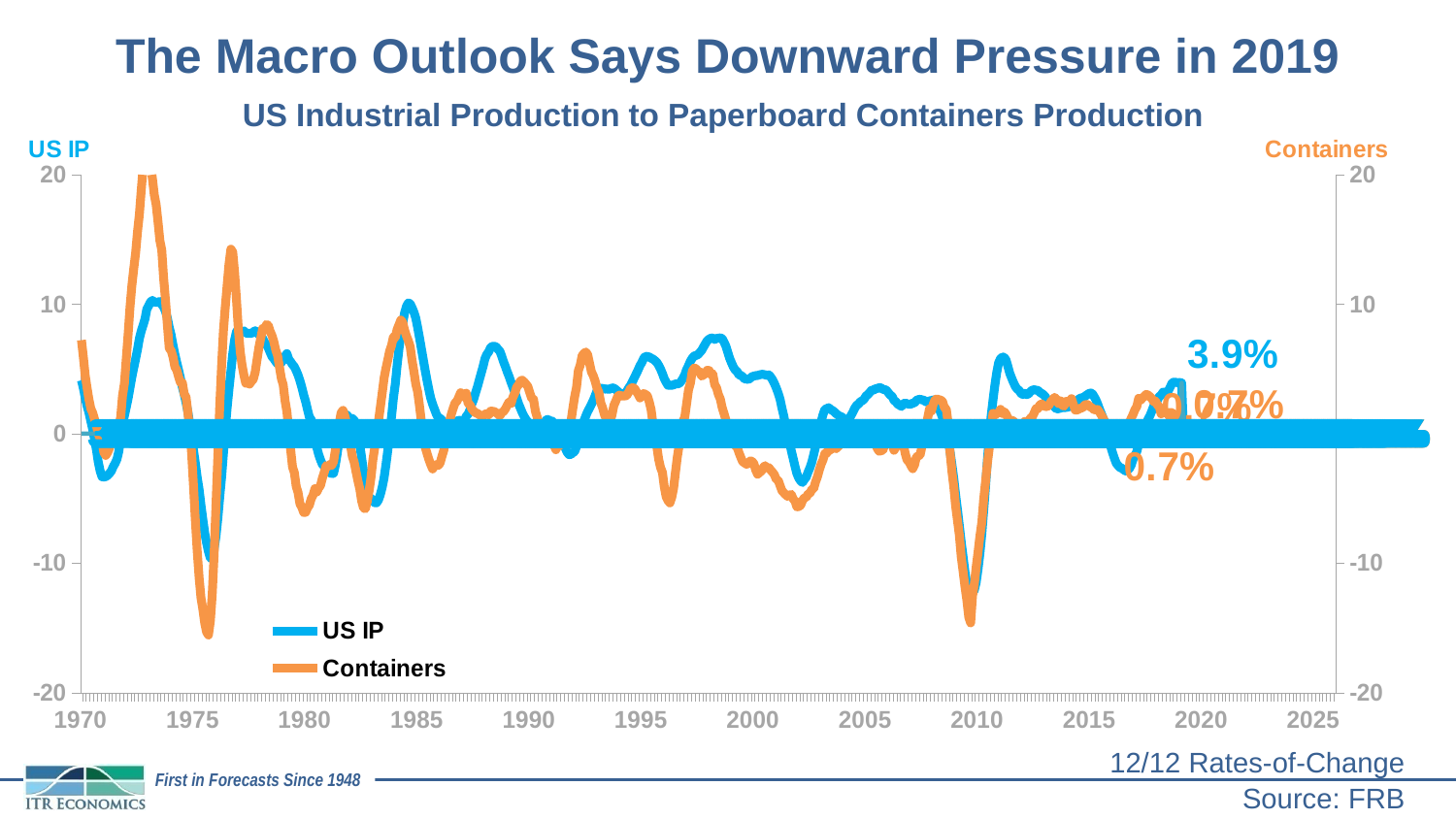
What is the title of the chart? US Industrial Production to Paperboard Containers Production Is the lowest value of the Containers series around 2009 greater or less than -10? less Is the lowest value of the US IP series around 2009 greater or less than -10? less At the trough around 1975, which series falls lower, US IP or Containers? Containers What are the two series named in the legend? US IP and Containers At the 1973 peak, which series reaches the higher value, US IP or Containers? Containers What is the most recent data label shown for the US IP series? 3.9% What kind of chart is shown on the slide? Line chart What is the data label shown in orange for the Containers series near 2017? 0.7% Is the lowest value of the Containers series around 1975 greater or less than -10? less How many series does the legend list? 2